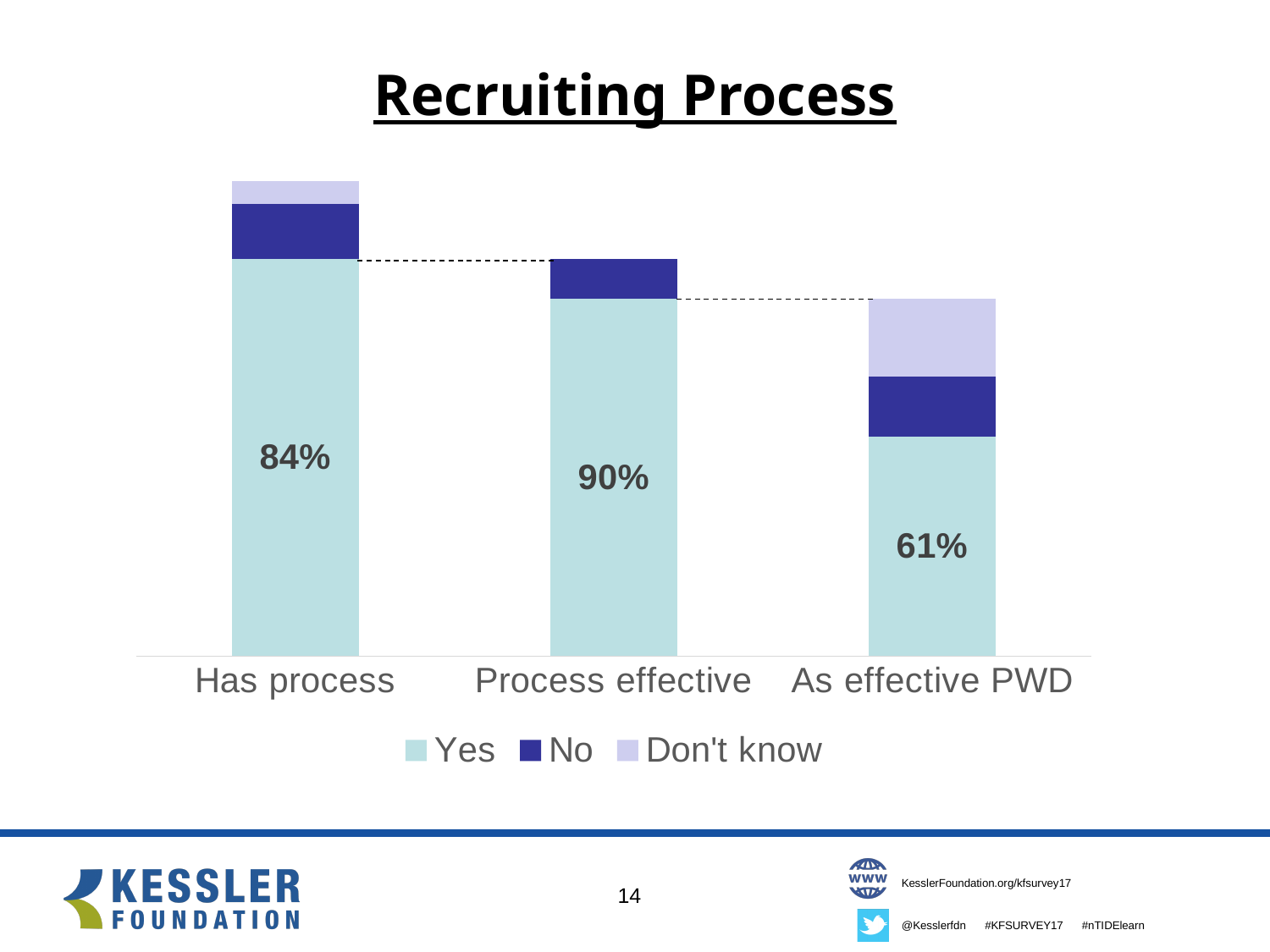
Which category has the highest Yes value? Process effective What is the difference between the Yes values for Process effective and Has process? 6% How many series does the legend list? 3 What is the Yes value for As effective PWD? 61% How many categories are shown on the x axis? 3 What is the Yes value for Has process? 84% Which category has the lowest Yes value? As effective PWD What is the difference between the Yes values for Has process and As effective PWD? 23% What kind of chart is shown on the slide? Stacked bar chart What is the Yes value for Process effective? 90% What is the title of the chart? Recruiting Process Which has a larger Yes value, Has process or As effective PWD? Has process